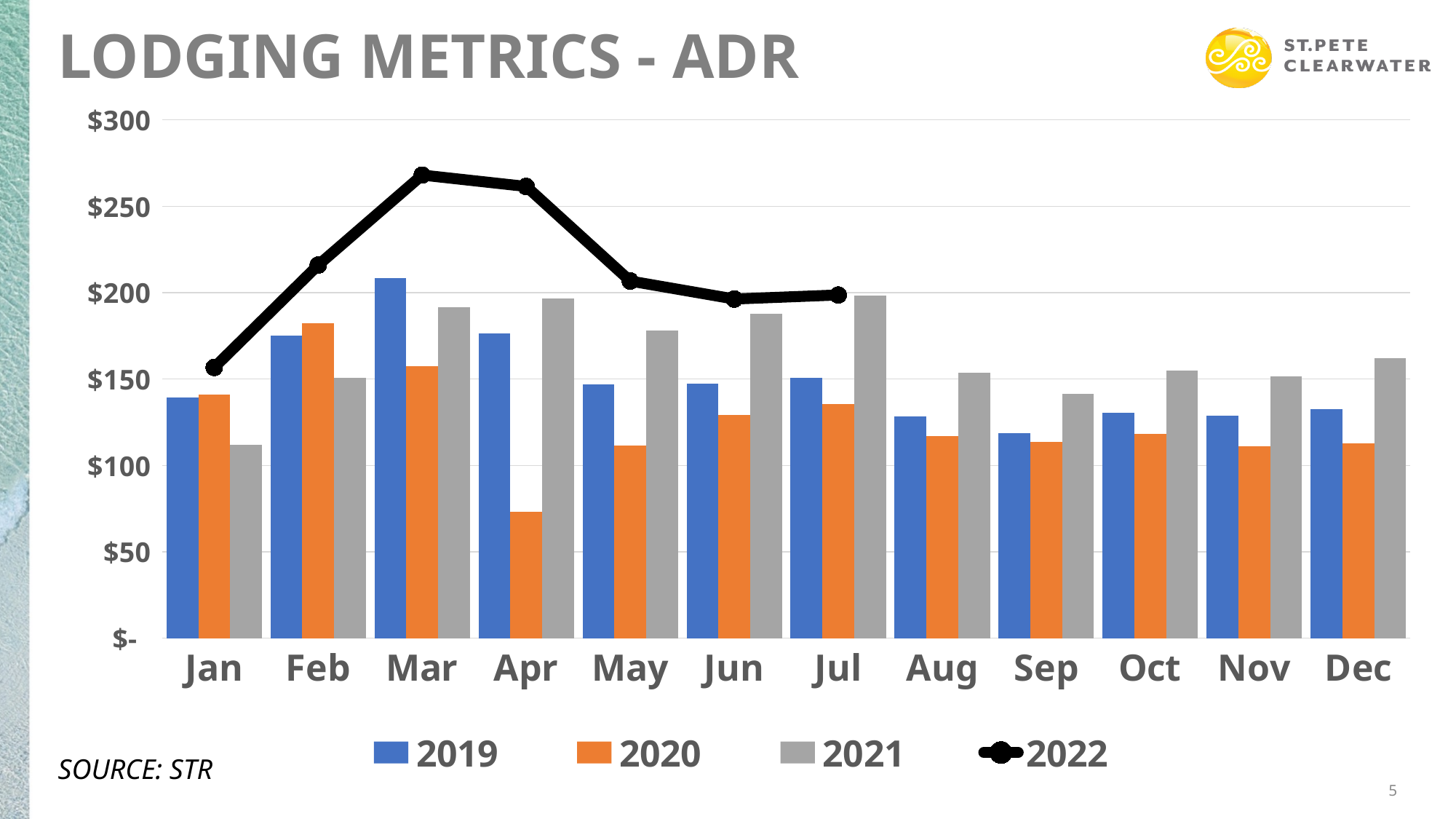
In which month is the 2021 value the lowest? Jan In which month is the 2020 value the lowest? Apr Is the 2020 value for Apr greater or less than $100? less In which month does the 2022 line reach its highest value? Mar Is the 2022 value for Mar greater or less than $250? greater What kind of chart is shown on the slide? A bar chart combined with a line How many series does the legend list? 4 In which month is the 2019 value the highest? Mar Does the 2022 line rise or fall from Mar to Jul? fall Is the 2021 value for Jan greater or less than $150? less How many months are shown along the x axis? 12 For Apr, which is larger: the 2020 value or the 2021 value? 2021